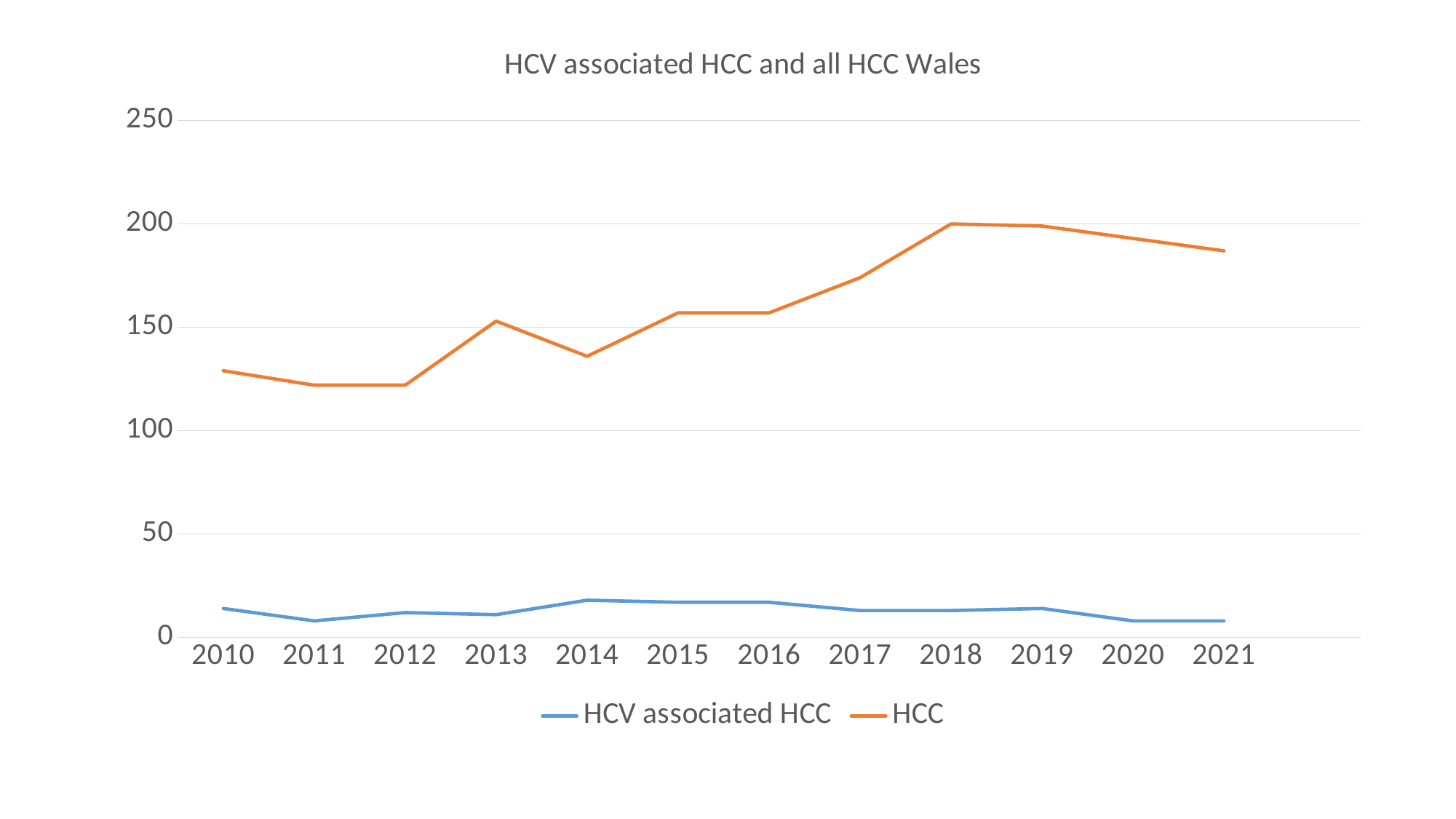
Is the HCV associated HCC value for 2014 greater or less than 50? less Does the HCC line overall rise or fall from 2010 to 2021? rise Which year has the larger HCC value, 2013 or 2014? 2013 Is the HCC value for 2010 greater or less than 150? less Which series has the higher value in 2018, HCV associated HCC or HCC? HCC What is the title of the chart? HCV associated HCC and all HCC Wales How many series does the legend list? 2 How many years are shown on the x axis? 12 Is the HCC value for 2017 greater or less than 150? greater What kind of chart is shown on the slide? line chart Which colour is the HCC line? orange